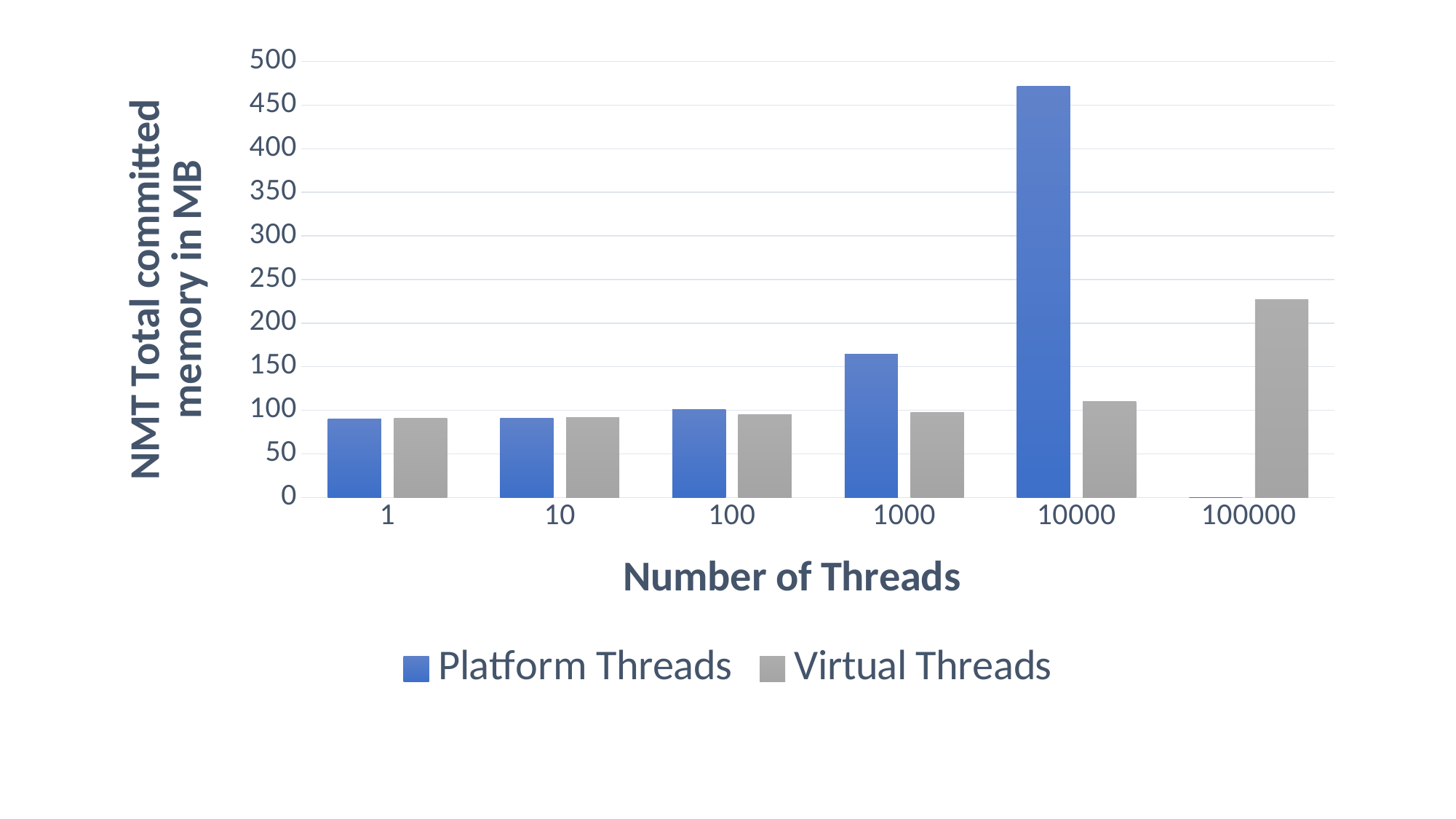
What kind of chart is shown on the slide? bar chart How many series does the legend list? 2 Is the Platform Threads value at 1000 threads greater or less than 150? greater For which number of threads is the Platform Threads bar lowest? 100000 Is the Virtual Threads value at 100000 threads greater or less than 200? greater What is the title of the vertical axis? NMT Total committed memory in MB At 100000 threads, which series has the larger committed memory, Platform Threads or Virtual Threads? Virtual Threads Is the Platform Threads value at 10000 threads greater or less than 400? greater How many thread-count categories are shown on the x axis? 6 For which number of threads is the Virtual Threads bar highest? 100000 At 10000 threads, which series has the larger committed memory, Platform Threads or Virtual Threads? Platform Threads For which number of threads is the Platform Threads bar highest? 10000